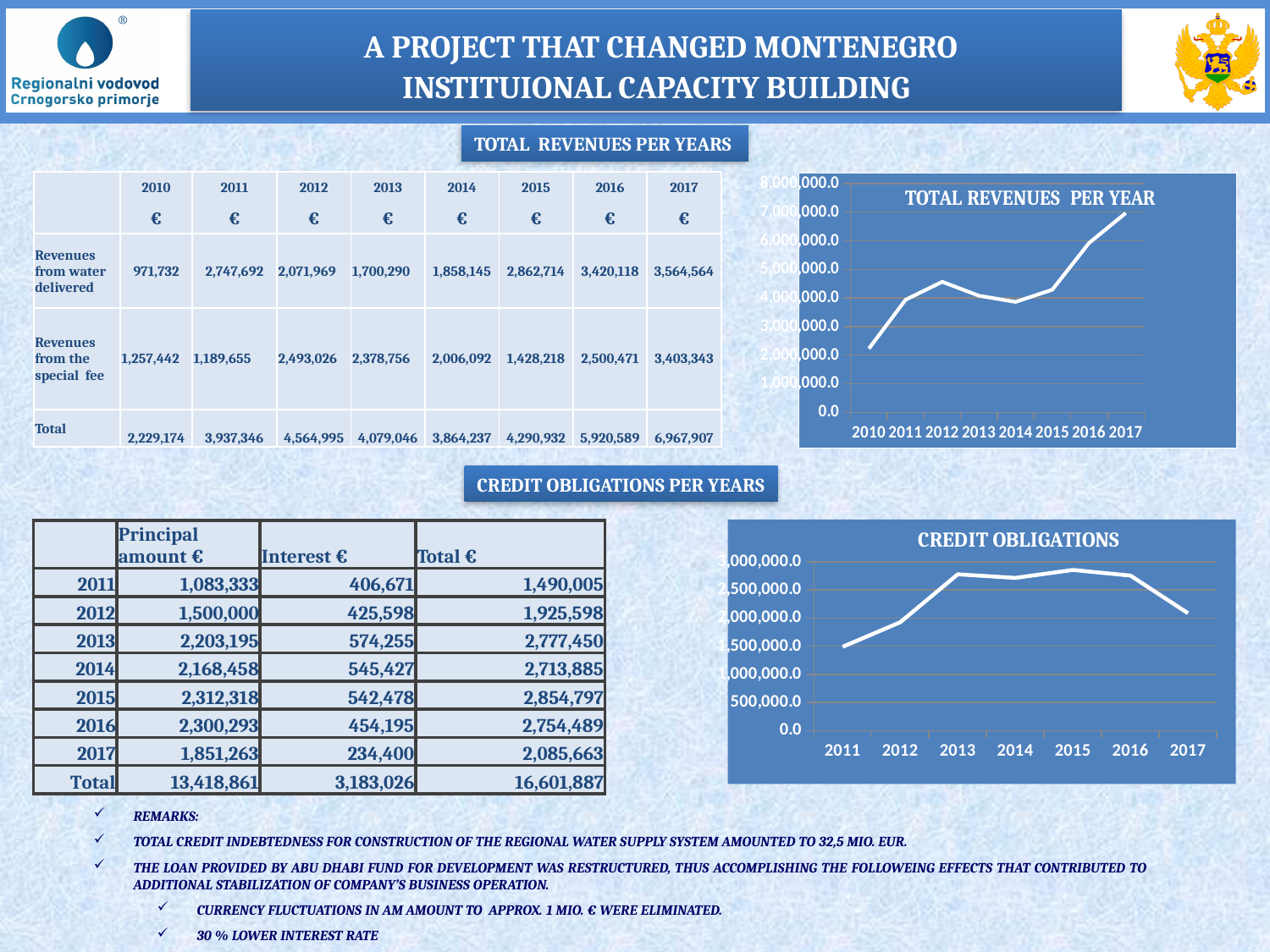
In the TOTAL REVENUES PER YEAR chart, which year has the lowest value? 2010 In the CREDIT OBLIGATIONS chart, which year has the lowest value? 2011 In the TOTAL REVENUES PER YEAR chart, how many years are plotted on the x axis? 8 In the TOTAL REVENUES PER YEAR chart, which year has the larger value, 2014 or 2016? 2016 In the TOTAL REVENUES PER YEAR chart, is the value for 2017 greater or less than 6,000,000.0? greater In the CREDIT OBLIGATIONS chart, how many years are plotted on the x axis? 7 In the CREDIT OBLIGATIONS chart, is the value for 2013 greater or less than 2,500,000.0? greater In the TOTAL REVENUES PER YEAR chart, is the value for 2010 greater or less than 3,000,000.0? less In the CREDIT OBLIGATIONS chart, do the values rise or fall from 2015 to 2017? fall What kind of chart is the CREDIT OBLIGATIONS chart? line chart In the TOTAL REVENUES PER YEAR chart, which year has the highest value? 2017 What kind of chart is the TOTAL REVENUES PER YEAR chart? line chart